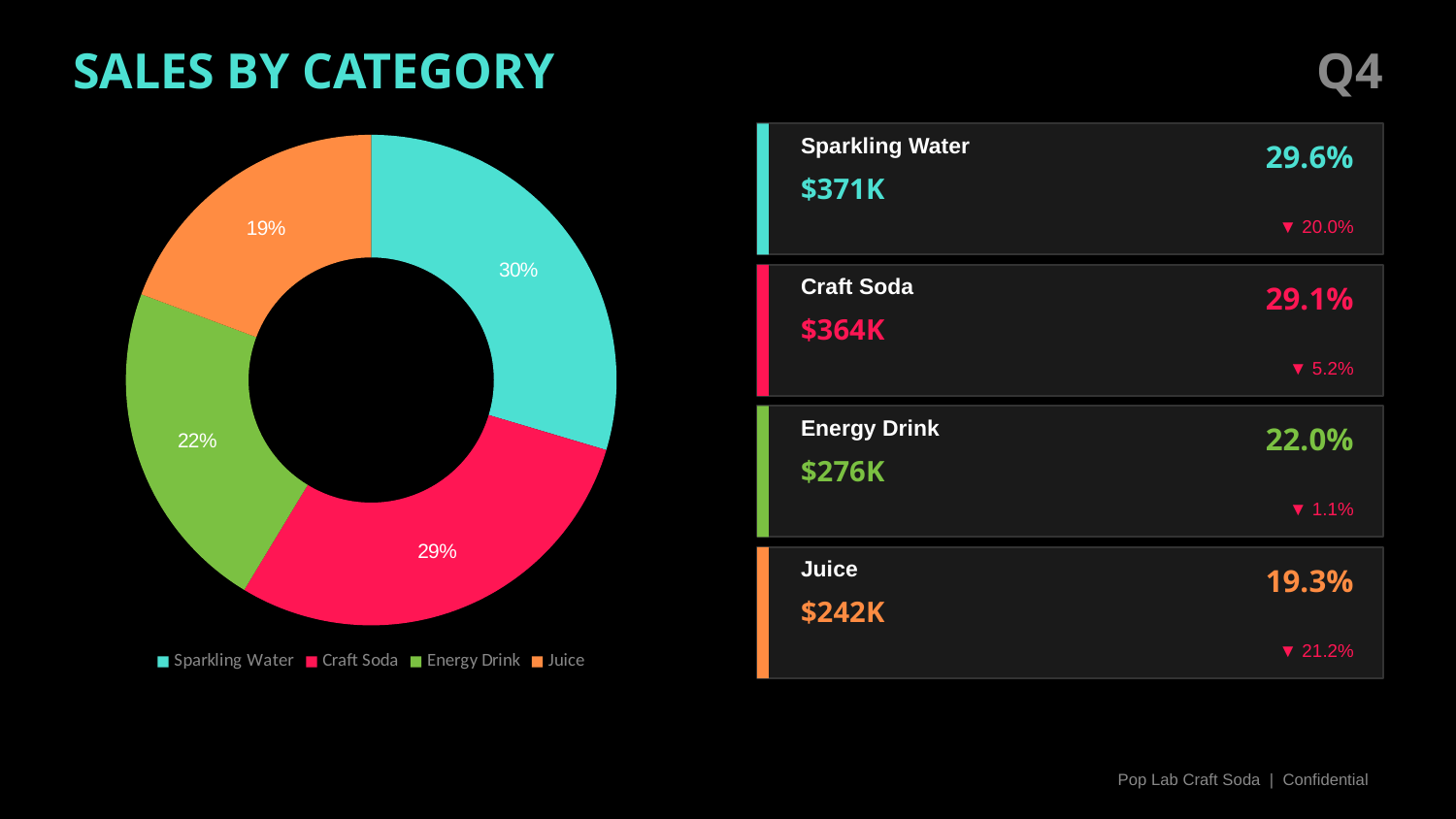
What share of the pie does Sparkling Water have in the Sales by Category chart? 30% What is the difference in percentage points between the Sparkling Water and Juice slices? 11 What percentage is shown for Juice in the donut chart? 19% What type of chart is used on the Sales by Category slide? Doughnut chart What is the title of the chart on this slide? SALES BY CATEGORY What percentage is shown for Craft Soda in the donut chart? 29% Which category is shown in green in the donut chart legend? Energy Drink Which category has the smallest slice in the Sales by Category chart? Juice Which category has the largest slice in the Sales by Category chart? Sparkling Water Which slice is larger in the donut chart, Energy Drink or Juice? Energy Drink How many categories are shown in the Sales by Category donut chart? 4 What percentage is shown for Energy Drink in the donut chart? 22%